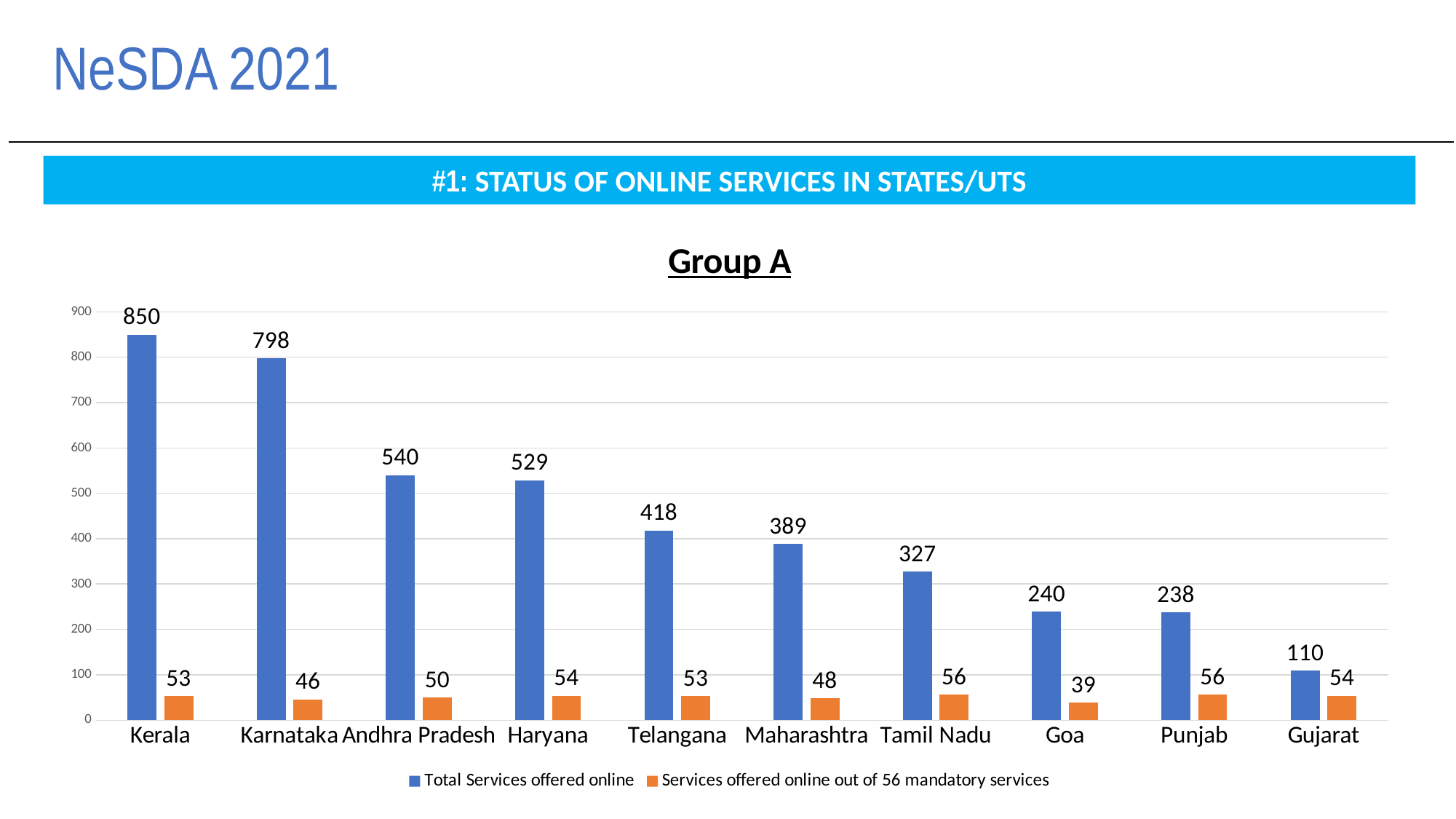
What is the title of the chart? Group A Which state has the lowest value for Services offered online out of 56 mandatory services? Goa How many Services offered online out of 56 mandatory services does Goa have? 39 How many states are shown on the x axis of the chart? 10 What type of chart is shown on the slide? Bar chart Is the Total Services offered online for Telangana greater or less than 400? greater How many series does the legend list? 2 Which has more Total Services offered online, Andhra Pradesh or Haryana? Andhra Pradesh Which state has the lowest Total Services offered online? Gujarat What is the value of Total Services offered online for Kerala? 850 What is the difference in Total Services offered online between Kerala and Karnataka? 52 Which state has the highest Total Services offered online? Kerala